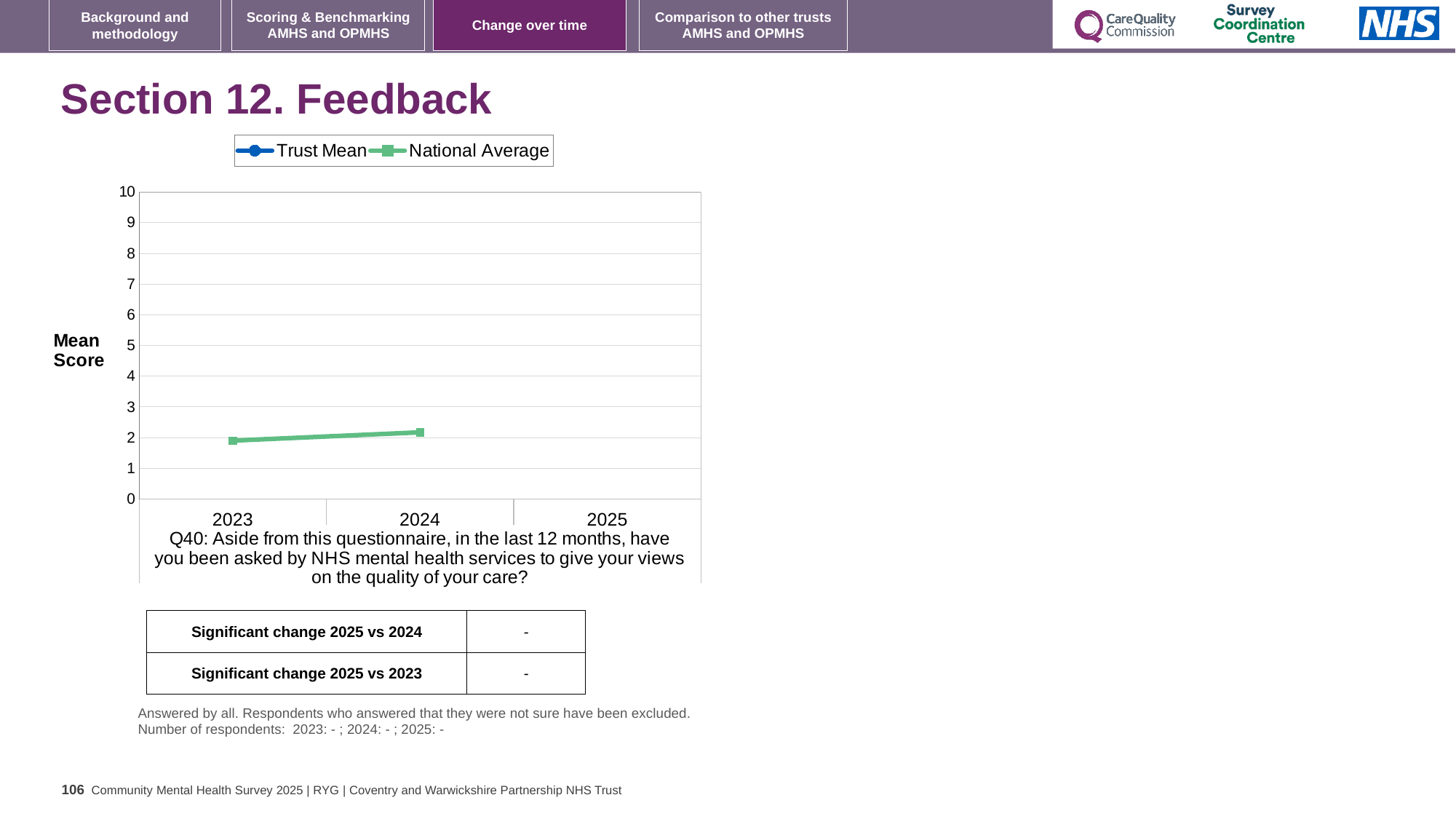
Is the National Average value for 2024 greater or less than 1? greater Does the National Average line rise or fall from 2023 to 2024? rise How many series does the chart legend list? 2 What is the highest value shown on the y axis of the chart? 10 Is the National Average value for 2023 greater or less than 3? less What are the two series named in the chart legend? Trust Mean and National Average Which year has the higher National Average value, 2023 or 2024? 2024 Is the National Average value for 2024 greater or less than 5? less How many years are shown on the x axis of the chart? 3 What is the label on the y axis of the chart? Mean Score What kind of chart is shown on the slide? line chart